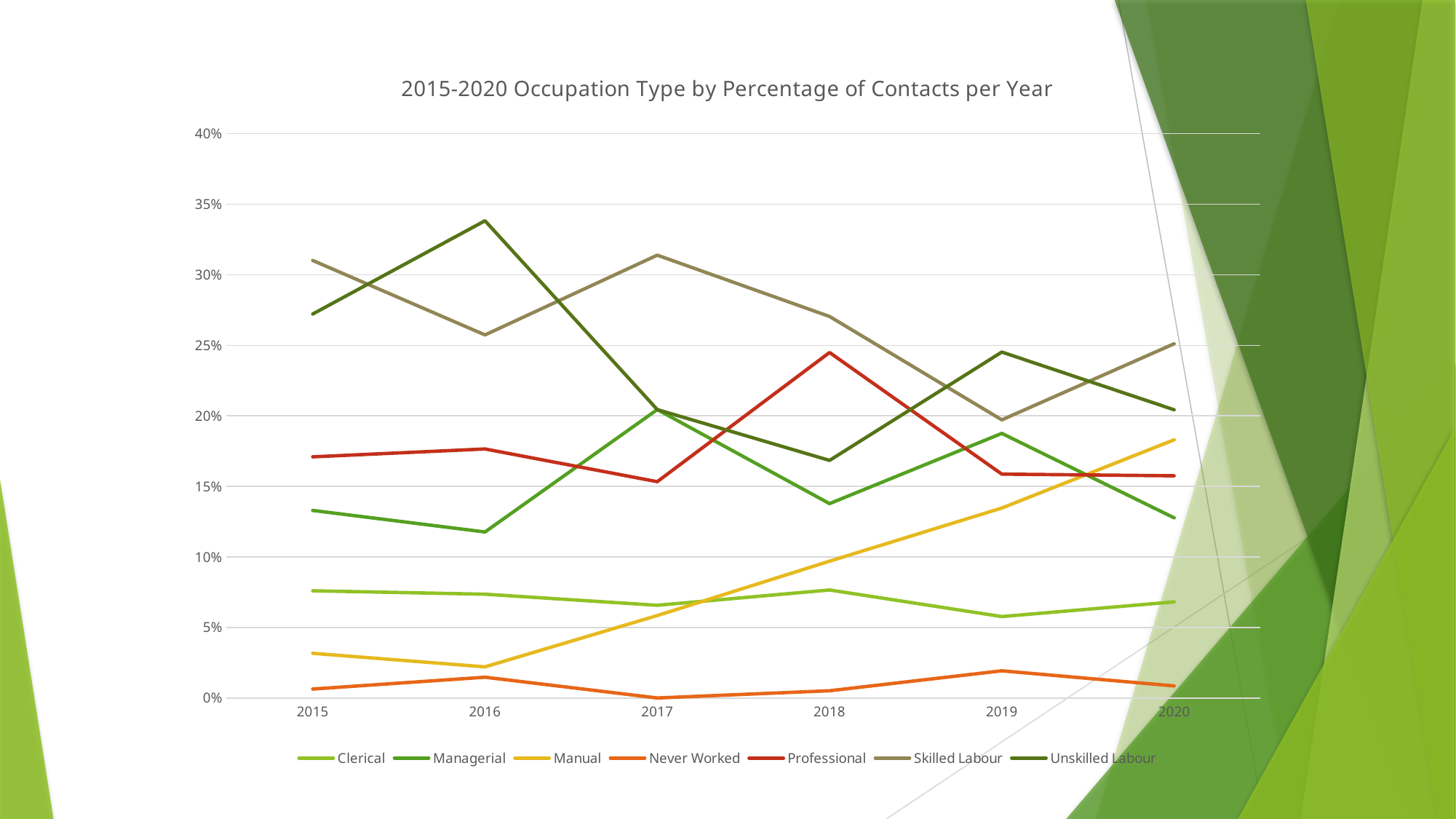
Which series has the lowest value in 2015? Never Worked Which series has the highest value in 2016? Unskilled Labour In 2018, which is larger: Professional or Managerial? Professional How many years are shown along the x axis? 6 How many series does the legend list? 7 Does the Manual series rise or fall from 2016 to 2020? rises Is the value for Never Worked in 2019 greater or less than 5%? less Is the value for Manual in 2020 greater or less than 15%? greater Is the value for Unskilled Labour in 2016 greater or less than 30%? greater What is the title of the chart? 2015-2020 Occupation Type by Percentage of Contacts per Year What kind of chart is shown on the slide? line chart In which year does the Unskilled Labour series reach its highest value? 2016